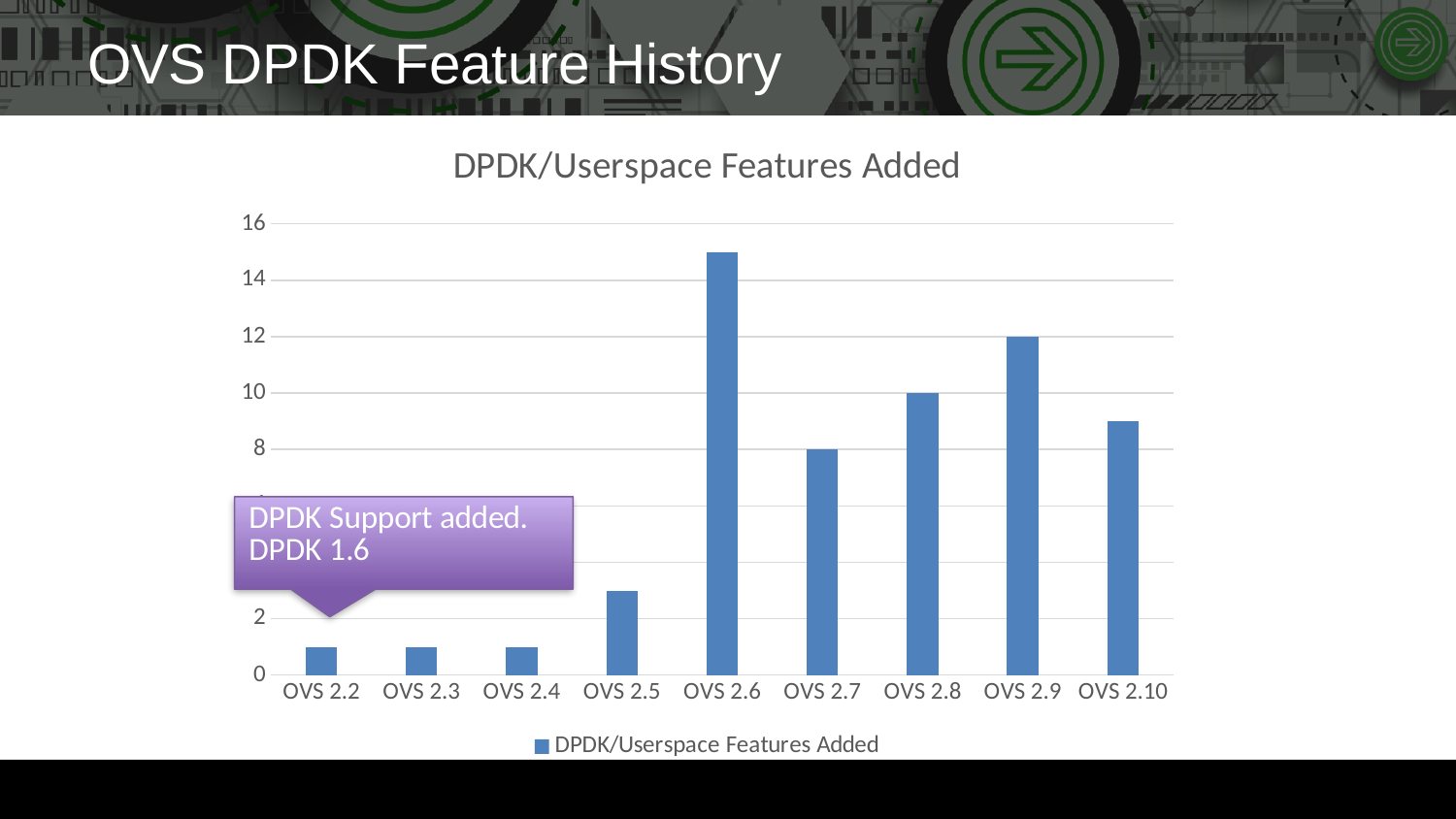
What is the value for OVS 2.8? 10 What is the difference between the values for OVS 2.9 and OVS 2.7? 4 What is the value for OVS 2.7? 8 How many series does the legend list? 1 Which OVS version has the highest number of DPDK/Userspace features added? OVS 2.6 What is the value for OVS 2.9? 12 Is the value for OVS 2.6 greater or less than 14? greater How many OVS versions are shown on the x axis? 9 Is the value for OVS 2.10 greater or less than 10? less What type of chart is shown on the slide? bar chart Which has a larger value, OVS 2.9 or OVS 2.8? OVS 2.9 What is the title of the chart? DPDK/Userspace Features Added